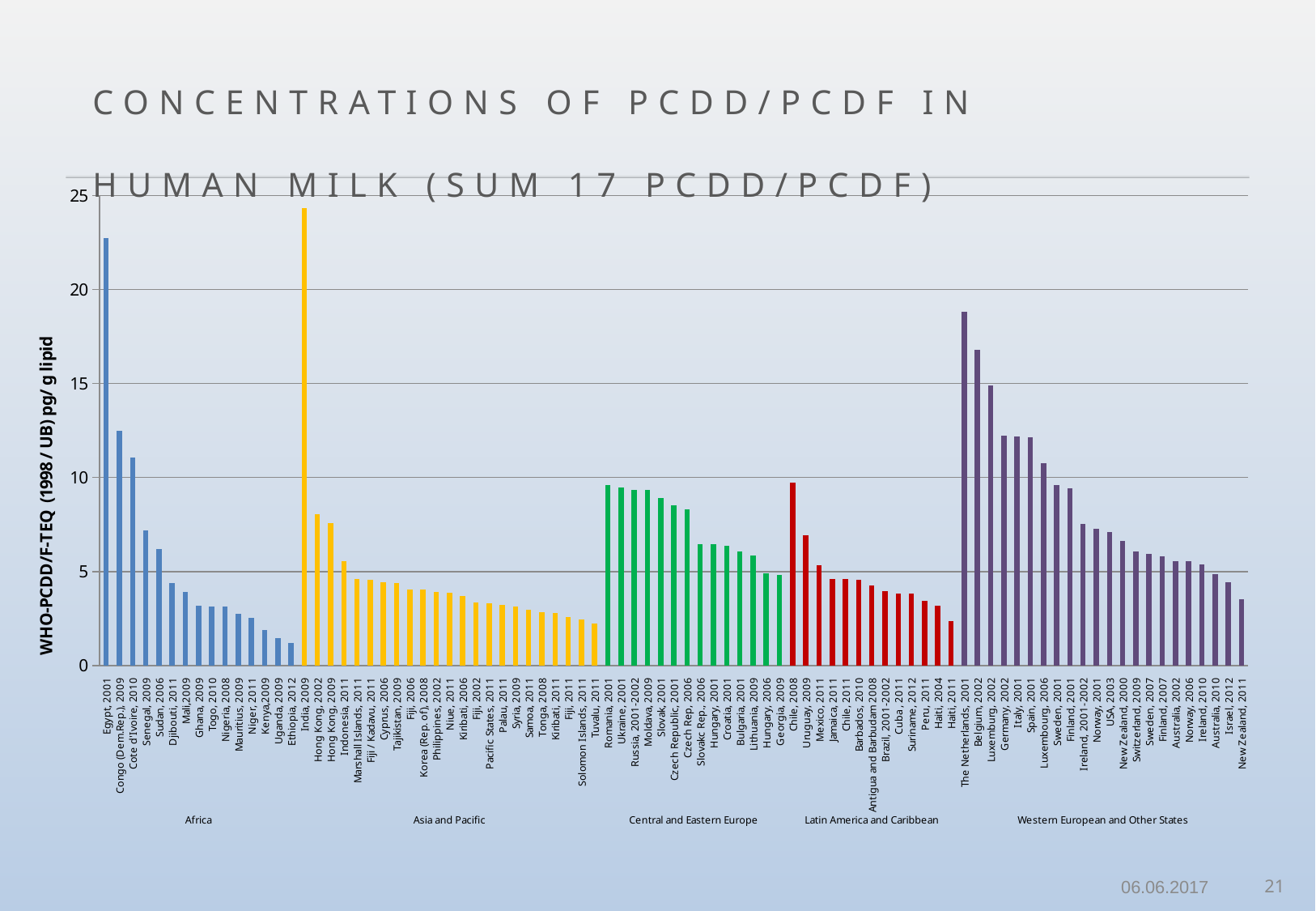
Which country/year has the highest concentration in the chart? India, 2009 Is the value for Hong Kong, 2002 greater or less than 10? less Is the value for Egypt, 2001 greater or less than 20? greater What is the title of the vertical axis? WHO-PCDD/F-TEQ (1998 / UB) pg/ g lipid Within the Western European and Other States group, which country/year has the lowest value? New Zealand, 2011 Which is larger, the value for Belgium, 2002 or the value for Luxemburg, 2002? Belgium, 2002 Within the Africa group, which country/year has the highest value? Egypt, 2001 Is the value for The Netherlands, 2001 greater or less than 15? greater Which is larger, the value for Egypt, 2001 or the value for The Netherlands, 2001? Egypt, 2001 What kind of chart is shown on the slide? Bar chart Within the Latin America and Caribbean group, which country/year has the highest value? Chile, 2008 How many regional groups are the bars divided into? 5